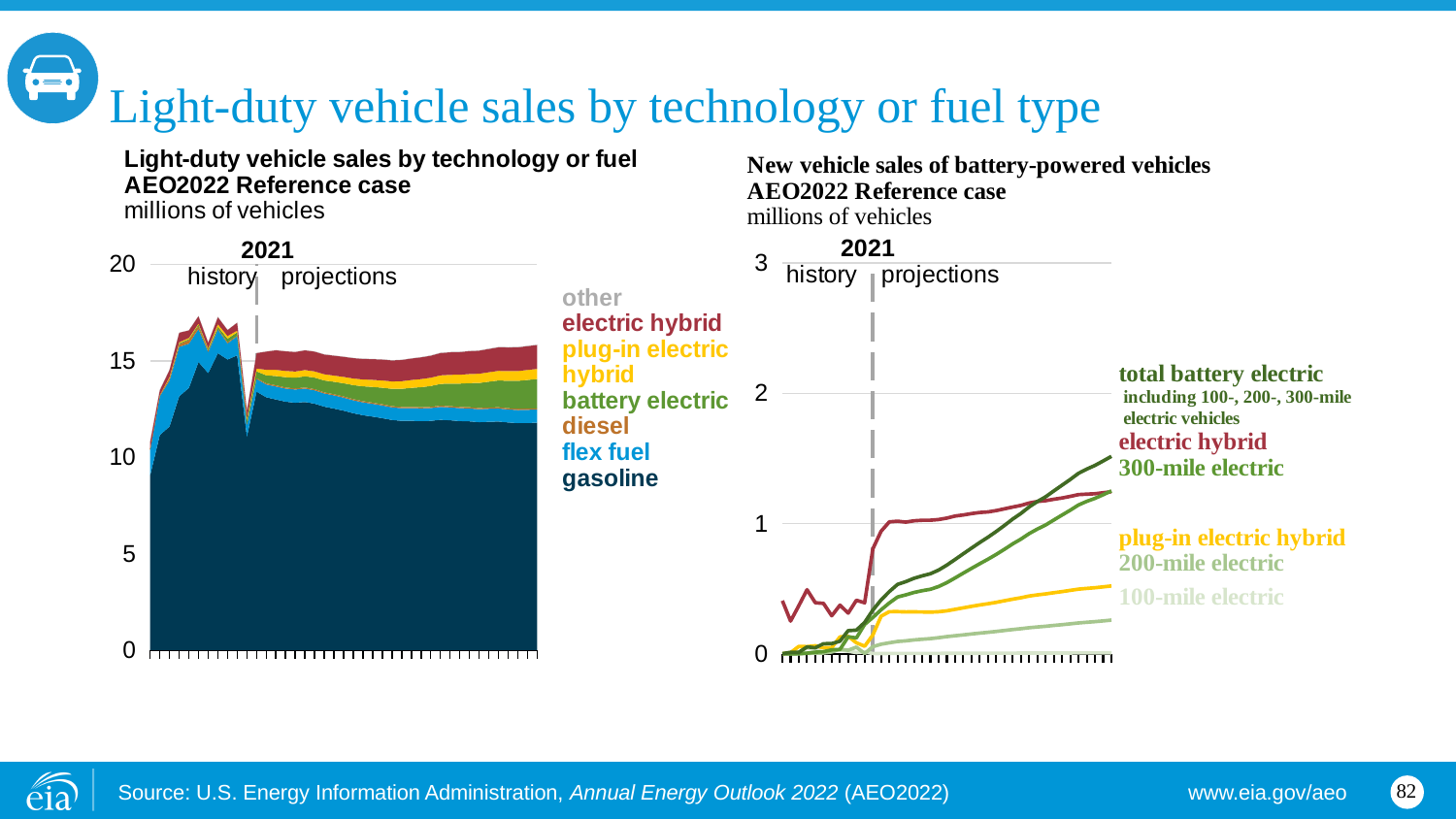
How many series are labeled on the right chart, 'New vehicle sales of battery-powered vehicles'? 6 In the right chart, 'New vehicle sales of battery-powered vehicles', which series is highest at the end of the projection period? total battery electric What year separates history from projections in both charts? 2021 In the right chart, 'New vehicle sales of battery-powered vehicles', is the value for 100-mile electric at the end of the projections greater or less than 1? less In the left chart, 'Light-duty vehicle sales by technology or fuel', which series makes up the largest share of sales? gasoline In the right chart, 'New vehicle sales of battery-powered vehicles', at the end of the projections, which is larger: electric hybrid or plug-in electric hybrid? electric hybrid What kind of chart is the right chart, 'New vehicle sales of battery-powered vehicles'? line chart In the right chart, 'New vehicle sales of battery-powered vehicles', does the total battery electric series rise or fall over the projection period? rise How many series does the legend of the left chart, 'Light-duty vehicle sales by technology or fuel', list? 7 What kind of chart is the left chart, 'Light-duty vehicle sales by technology or fuel'? stacked area chart In the right chart, 'New vehicle sales of battery-powered vehicles', which series is lowest at the end of the projection period? 100-mile electric In the right chart, 'New vehicle sales of battery-powered vehicles', is the value for total battery electric at the end of the projections greater or less than 1? greater